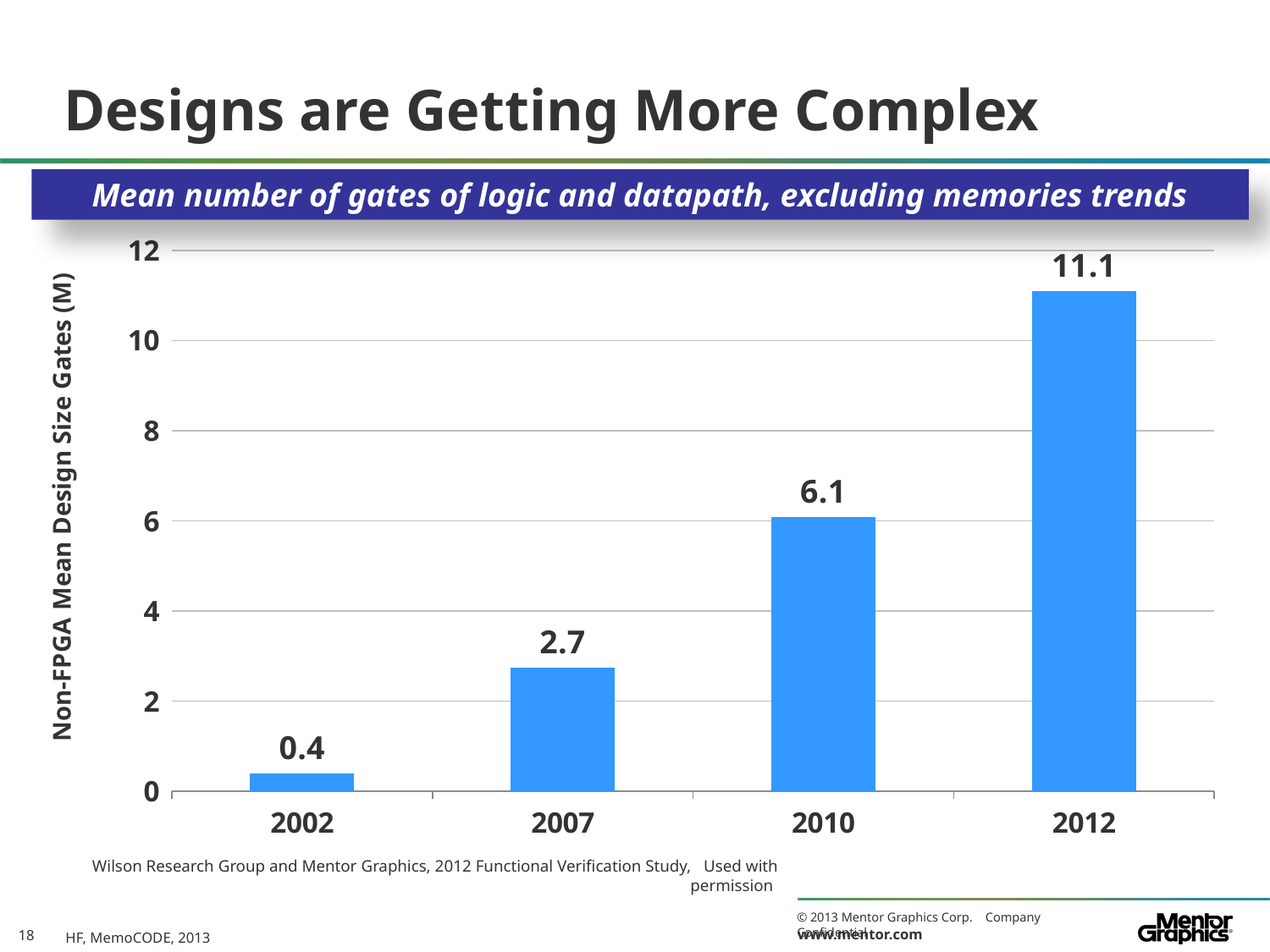
What is the Non-FPGA mean design size in gates (M) for 2010? 6.1 What is the Non-FPGA mean design size in gates (M) for 2012? 11.1 What is the difference between the mean design size in 2007 and in 2002? 2.3 What kind of chart is shown on the slide? Bar chart How many years are shown on the x axis of the chart? 4 What is the Non-FPGA mean design size in gates (M) for 2007? 2.7 Which year has the highest mean design size? 2012 Which year has a larger mean design size, 2007 or 2010? 2010 Do the values rise or fall from 2002 to 2012? Rise What is the difference between the mean design size in 2012 and in 2010? 5.0 What is the Non-FPGA mean design size in gates (M) for 2002? 0.4 Which year has the lowest mean design size? 2002